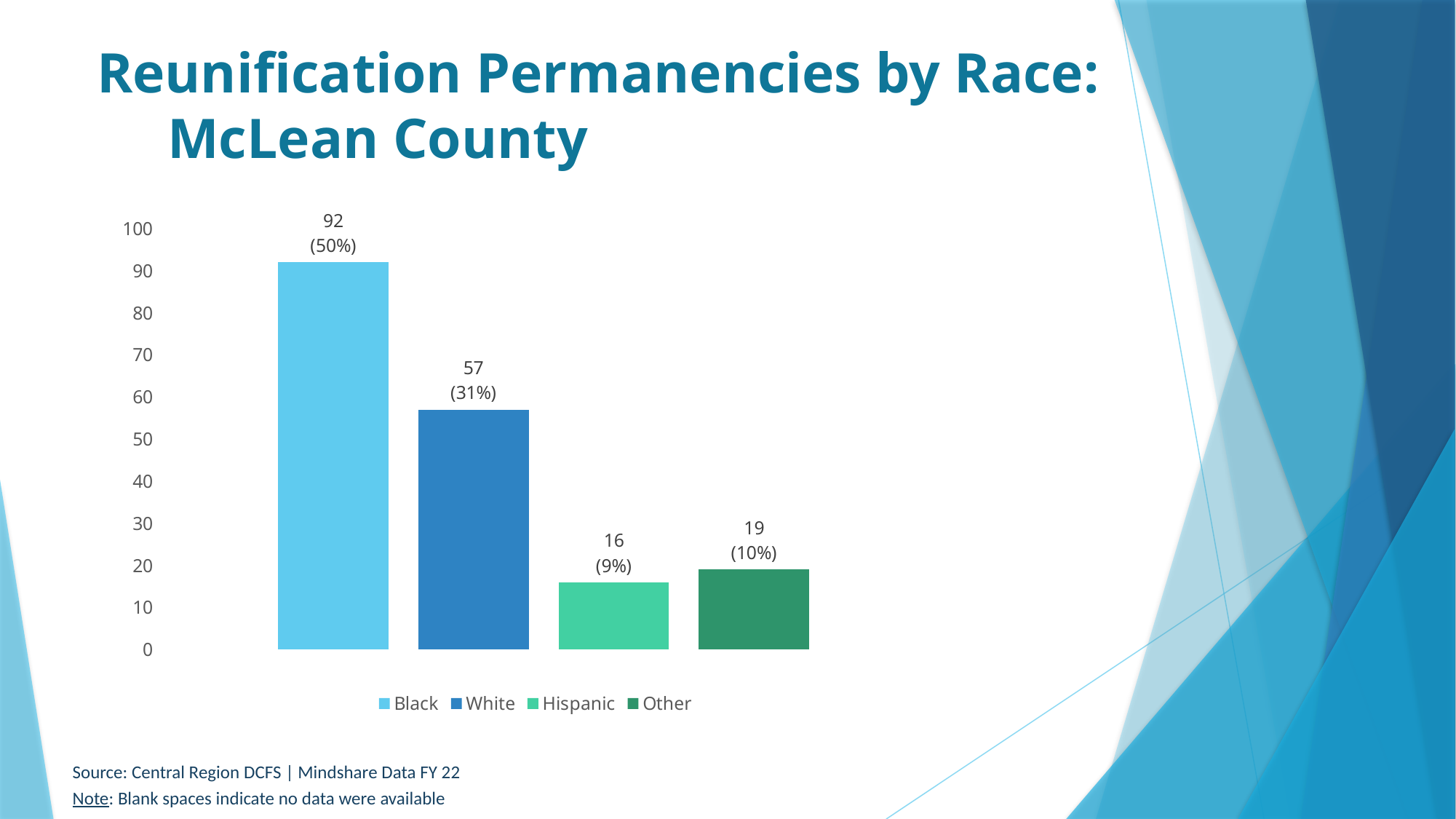
Which category has the highest value? Black Which is larger, the value for Other or the value for Hispanic? Other What is the difference between the values for Black and White? 35 What is the value for Black? 92 Is the value for White greater or less than 50? greater What is the value for Hispanic? 16 What kind of chart is shown on the slide? bar chart What is the title of the slide? Reunification Permanencies by Race: McLean County How many categories are shown in the chart? 4 What is the value for White? 57 What percentage is shown for Other? 10% Which category has the lowest value? Hispanic